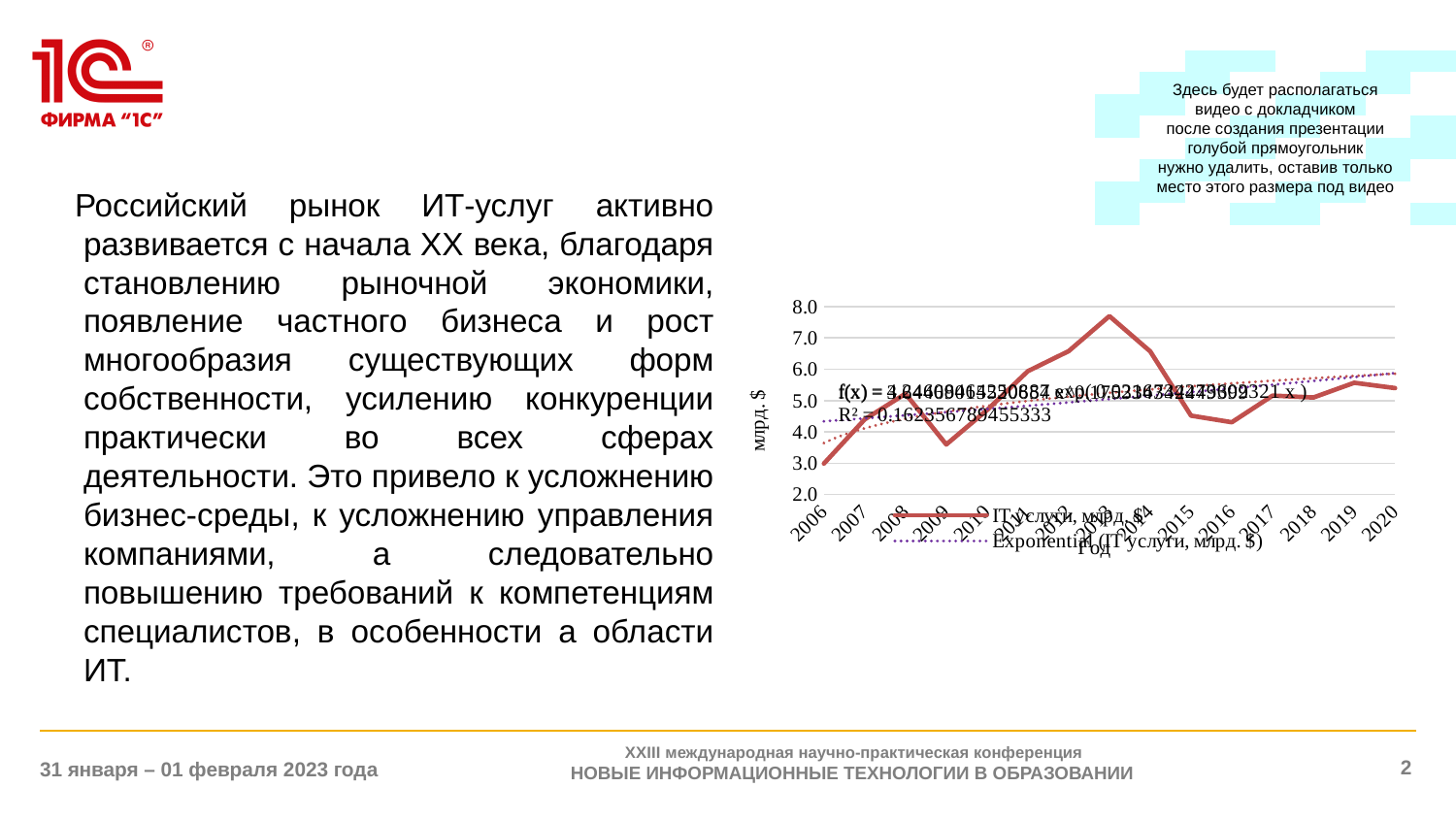
In which year does the IT услуги line reach its highest value? 2013 What is the first entry in the chart legend? IT услуги, млрд. $ Which year has the larger value, 2013 or 2016? 2013 How many series does the chart legend list? 2 What kind of chart is shown on the slide? line chart How many years are shown along the x axis of the chart? 15 What is the label on the vertical axis of the chart? млрд. $ Is the value for 2006 greater or less than 4.0? less In which year does the IT услуги line have its lowest value? 2006 Is the value for 2014 greater or less than 7.0? less